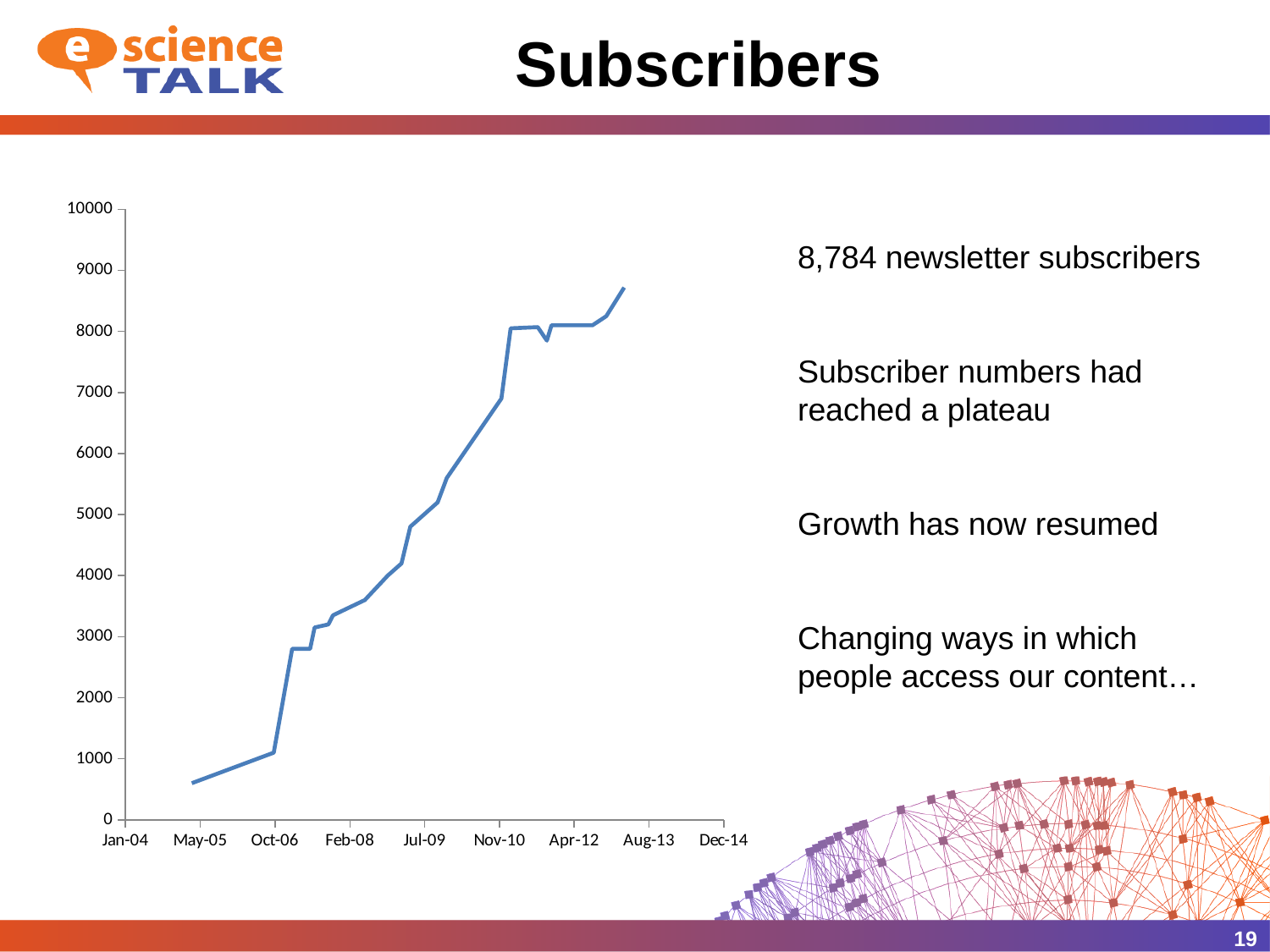
Is the value of the line at Oct-06 greater or less than 2000? less What is the first label on the x axis? Jan-04 Is the highest point of the line greater or less than 9000? less Is the value at the right-hand end of the line greater or less than 8000? greater What kind of chart is shown on the slide? line chart Which is larger, the value of the line at Jul-09 or at Oct-06? Jul-09 Do the subscriber values generally rise or fall from left to right along the x axis? rise How many date labels are shown on the x axis? 9 What is the highest value shown on the y axis? 10000